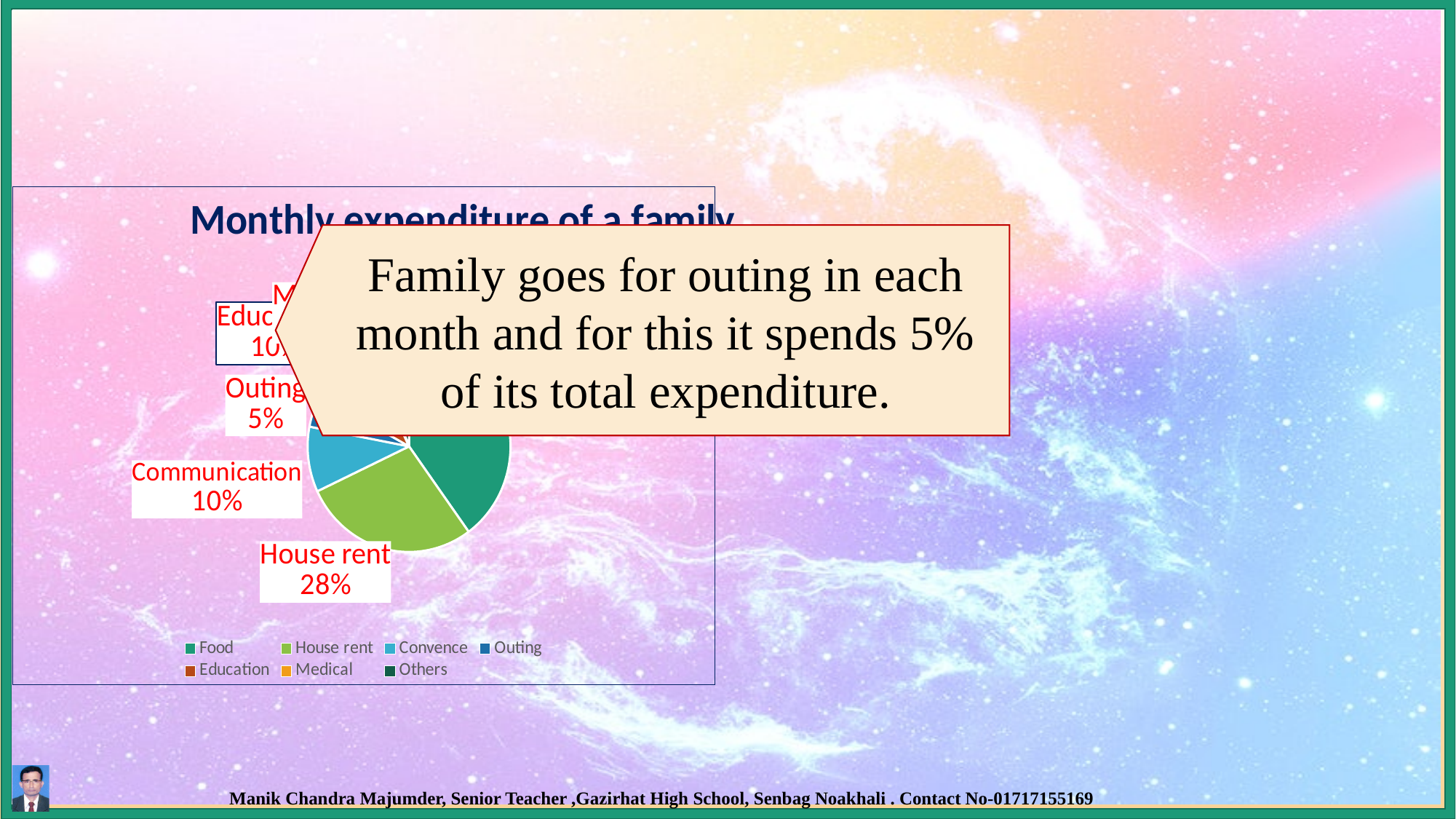
What percentage of the monthly expenditure goes to House rent? 28% How many entries does the legend list? 7 Which is larger, the share for House rent or the share for Outing? House rent What is the title of the chart? Monthly expenditure of a family Which category is listed first in the legend? Food What percentage of the monthly expenditure goes to Outing? 5% What is the difference between the House rent share and the Outing share? 23% What percentage of the monthly expenditure goes to Communication? 10% What kind of chart is shown on the slide? pie chart What is the difference between the House rent share and the Communication share? 18% Which is larger, the share for Communication or the share for Outing? Communication